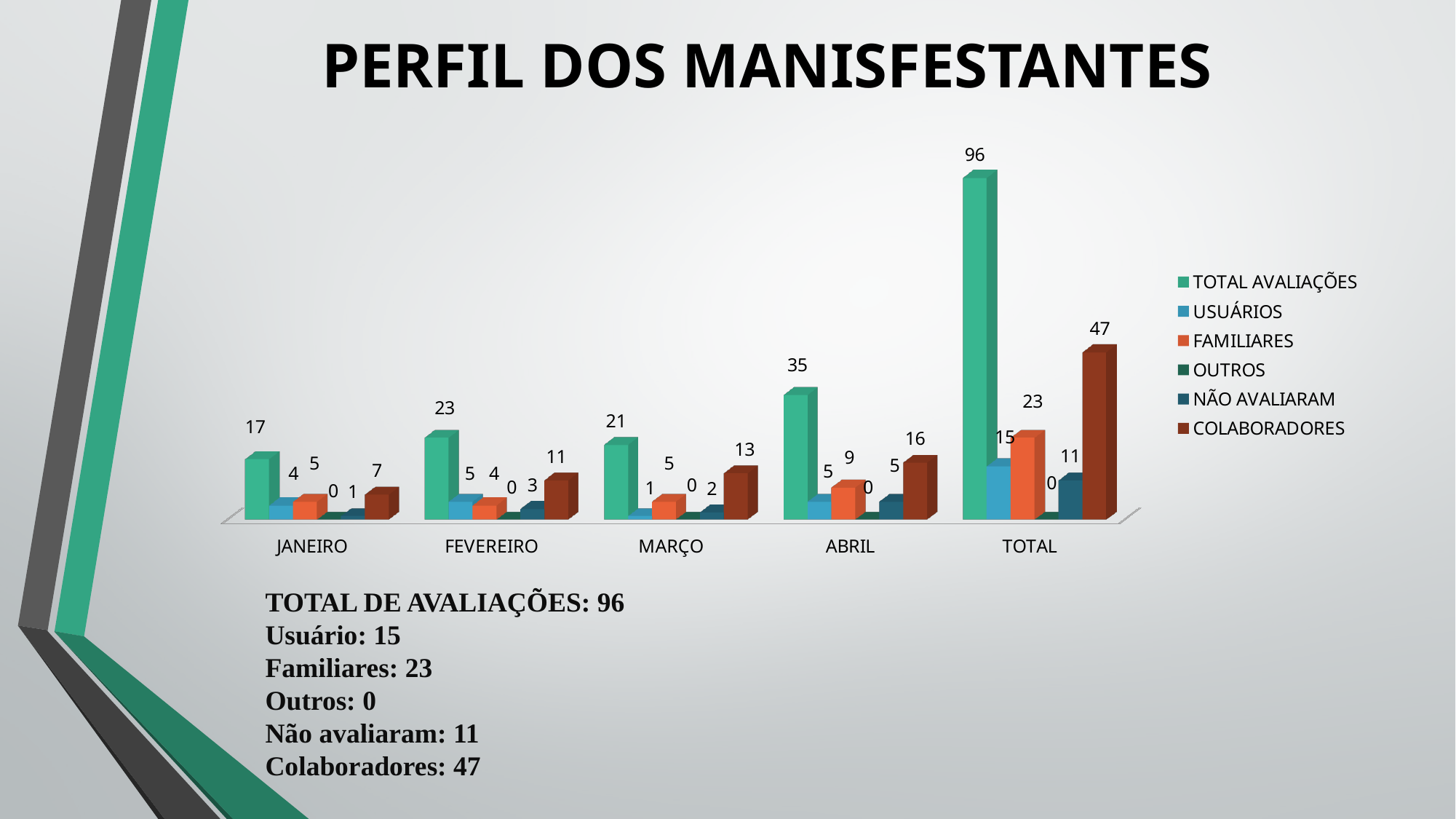
What is the value of FAMILIARES for JANEIRO? 5 What is the value of COLABORADORES for MARÇO? 13 What is the value of NÃO AVALIARAM for FEVEREIRO? 3 How many categories are shown on the x axis? 5 Do the COLABORADORES values rise or fall from JANEIRO to ABRIL? Rise What kind of chart is shown on the slide? Bar chart What is the value of TOTAL AVALIAÇÕES for ABRIL? 35 Which month (excluding TOTAL) has the lowest COLABORADORES value? JANEIRO Which is larger for ABRIL: the USUÁRIOS value or the FAMILIARES value? FAMILIARES Which month (excluding TOTAL) has the highest TOTAL AVALIAÇÕES value? ABRIL How many series does the legend list? 6 What is the difference between the TOTAL AVALIAÇÕES values for FEVEREIRO and JANEIRO? 6